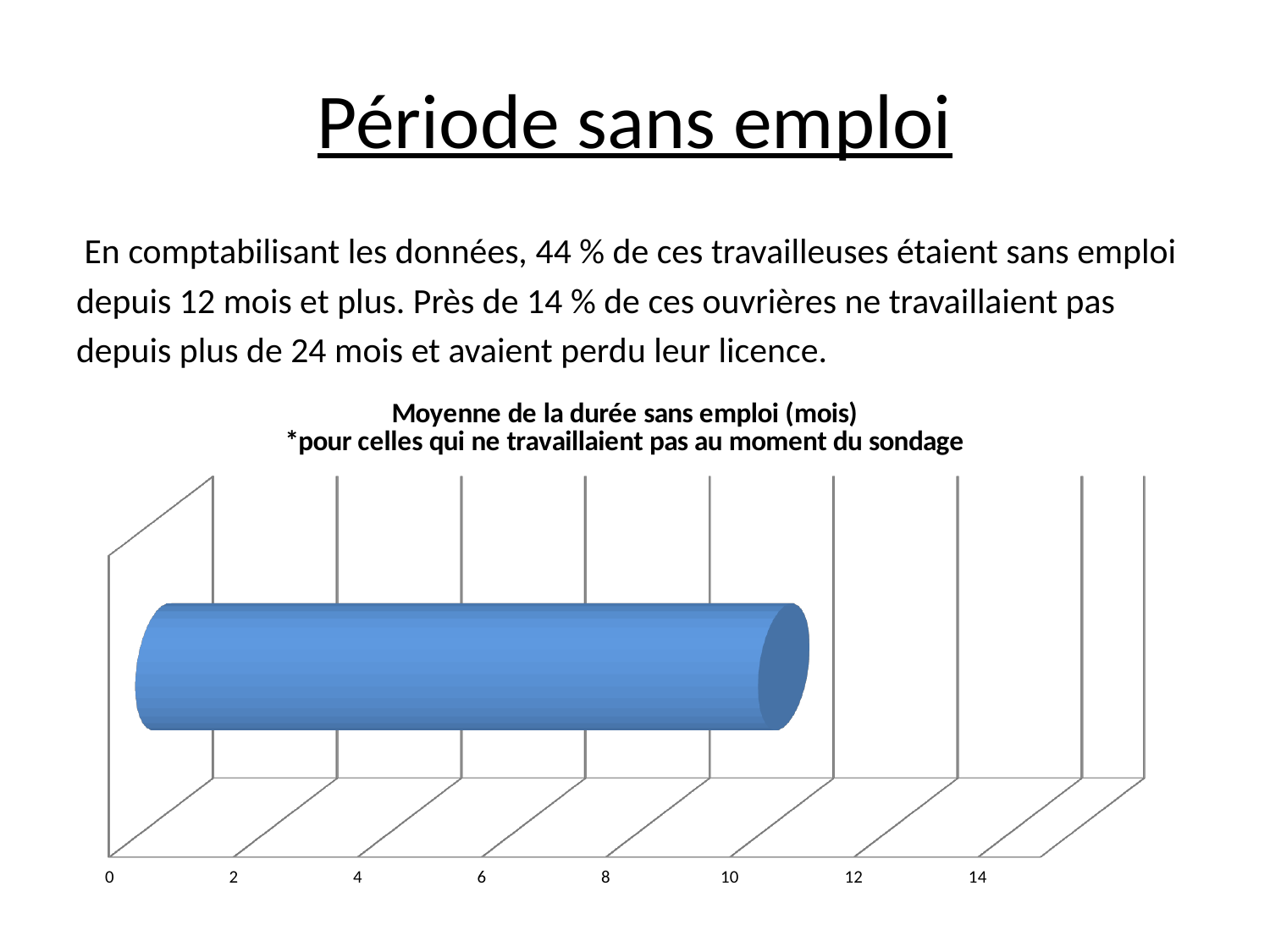
What is the highest tick value shown on the horizontal axis of the chart? 14 What is the title of the chart? Moyenne de la durée sans emploi (mois) *pour celles qui ne travaillaient pas au moment du sondage How many bars are plotted in the chart? 1 Is the value of the bar in the chart greater or less than 8? greater Is the value of the bar in the chart greater or less than 12? less What kind of chart is shown on the slide? bar chart